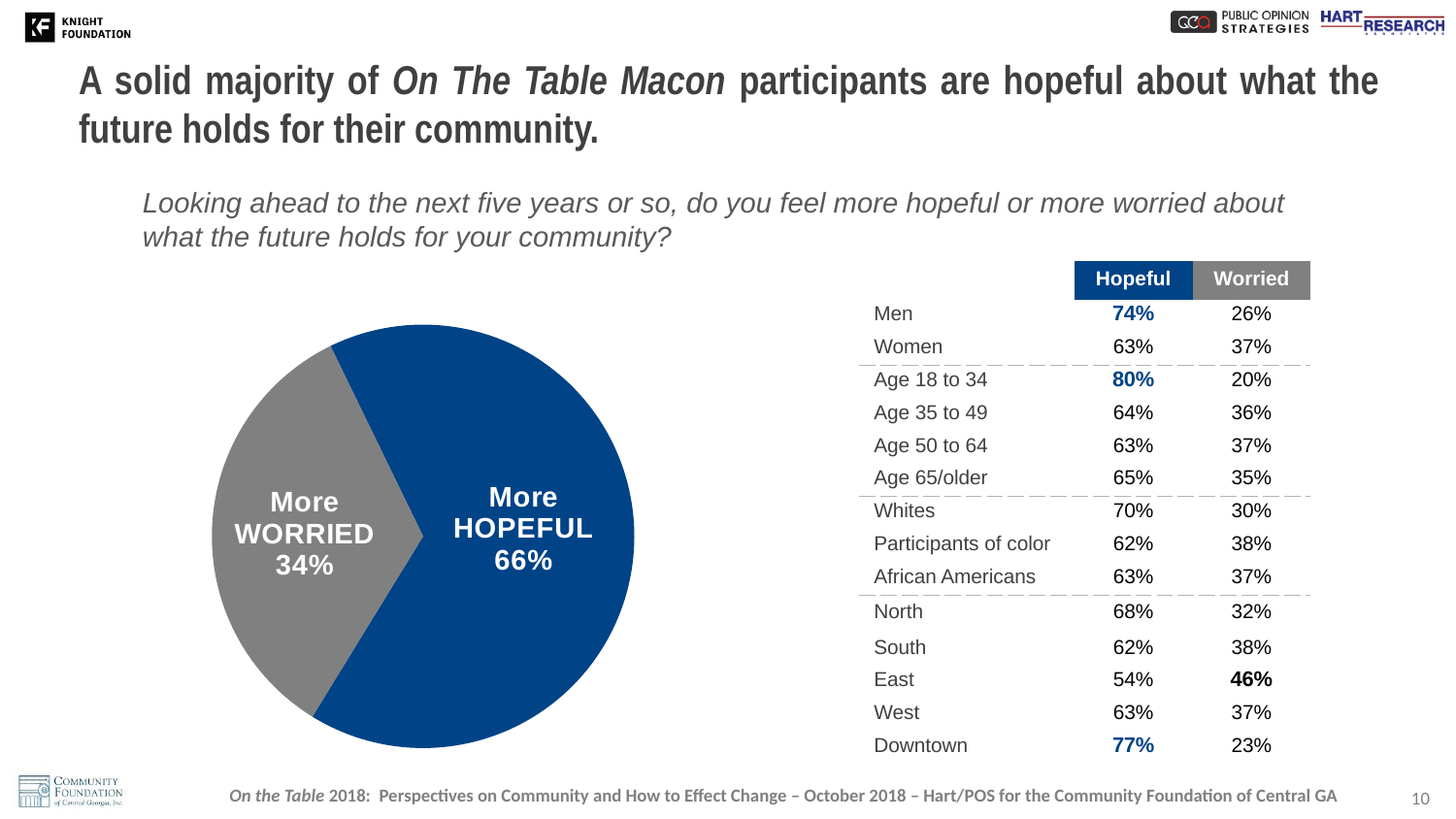
What kind of chart is shown on the slide? pie chart What is the difference in percentage points between the More HOPEFUL and More WORRIED slices? 32 What percentage of participants are More HOPEFUL according to the pie chart? 66% What percentage of participants are More WORRIED according to the pie chart? 34% Which is larger in the pie chart, More HOPEFUL or More WORRIED? More HOPEFUL What colour is the More HOPEFUL slice of the pie chart? blue What share of the pie does the More HOPEFUL slice represent? 66% What colour is the More WORRIED slice of the pie chart? gray Which slice of the pie chart is the largest? More HOPEFUL Which slice of the pie chart is the smallest? More WORRIED How many slices does the pie chart have? 2